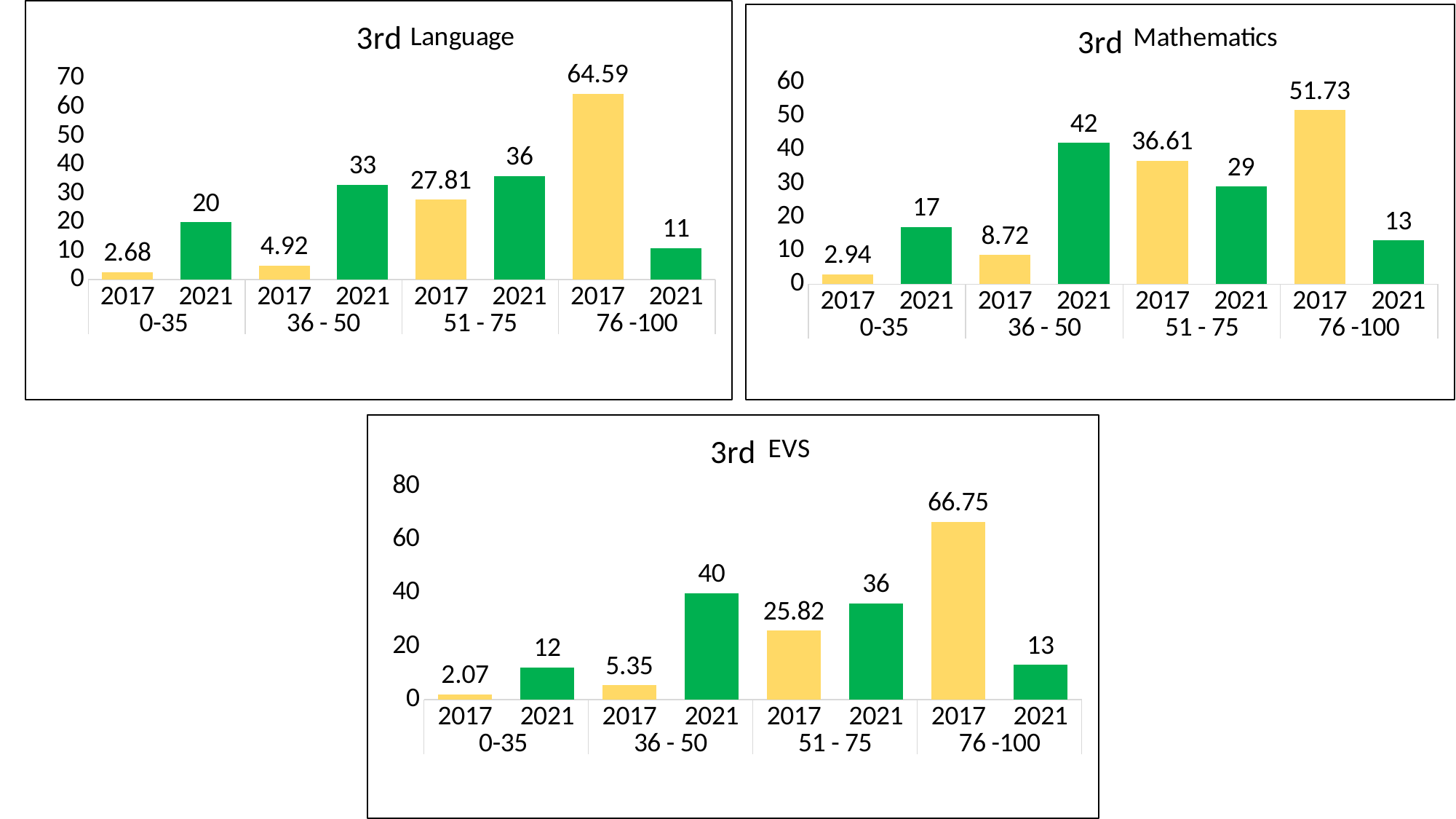
In the '3rd EVS' chart, is the value for 2017 in the 76 -100 band greater or less than 60? greater In the '3rd Mathematics' chart, what is the difference between the 2017 and 2021 values in the 76 -100 band? 38.73 What kind of chart is the '3rd EVS' chart? bar chart How many bars are plotted in the '3rd Mathematics' chart? 8 In the '3rd Language' chart, which is larger: the 2021 value for 36 - 50 or the 2021 value for 51 - 75? 2021 value for 51 - 75 In the '3rd Mathematics' chart, what is the value for 2021 in the 36 - 50 band? 42 In the '3rd EVS' chart, what is the value for 2017 in the 51 - 75 band? 25.82 In the '3rd Mathematics' chart, do the 2017 values rise or fall from the 0-35 band to the 76 -100 band? rise How many charts are shown on the slide? 3 In the '3rd Language' chart, what is the value for 2017 in the 76 -100 band? 64.59 In the '3rd EVS' chart, which bar has the lowest value? 2017, 0-35 In the '3rd Language' chart, which bar has the highest value? 2017, 76 -100